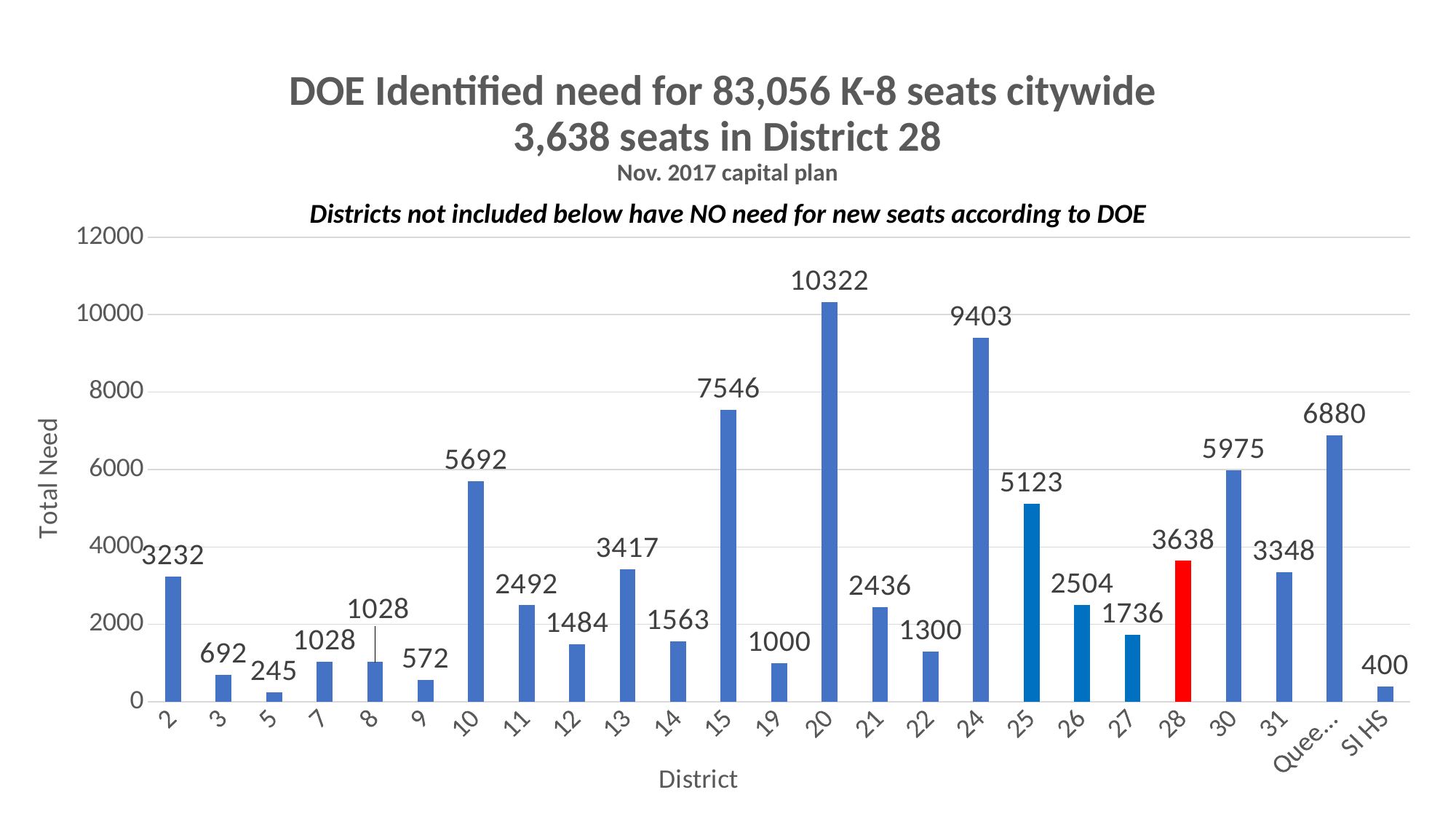
What is the difference in total need between District 20 and District 24? 919 What is the total need for SI HS? 400 Which district's bar is coloured red? 28 What is the difference in total need between District 15 and District 10? 1854 How many districts are shown on the x axis? 25 What kind of chart is shown on the slide? bar chart Which has a larger total need, District 30 or District 25? District 30 Which district has the highest total need? 20 What is the total need for District 28? 3638 Is the value for District 13 greater or less than 4000? less Which district has the lowest total need? 5 What is the total need for District 20? 10322